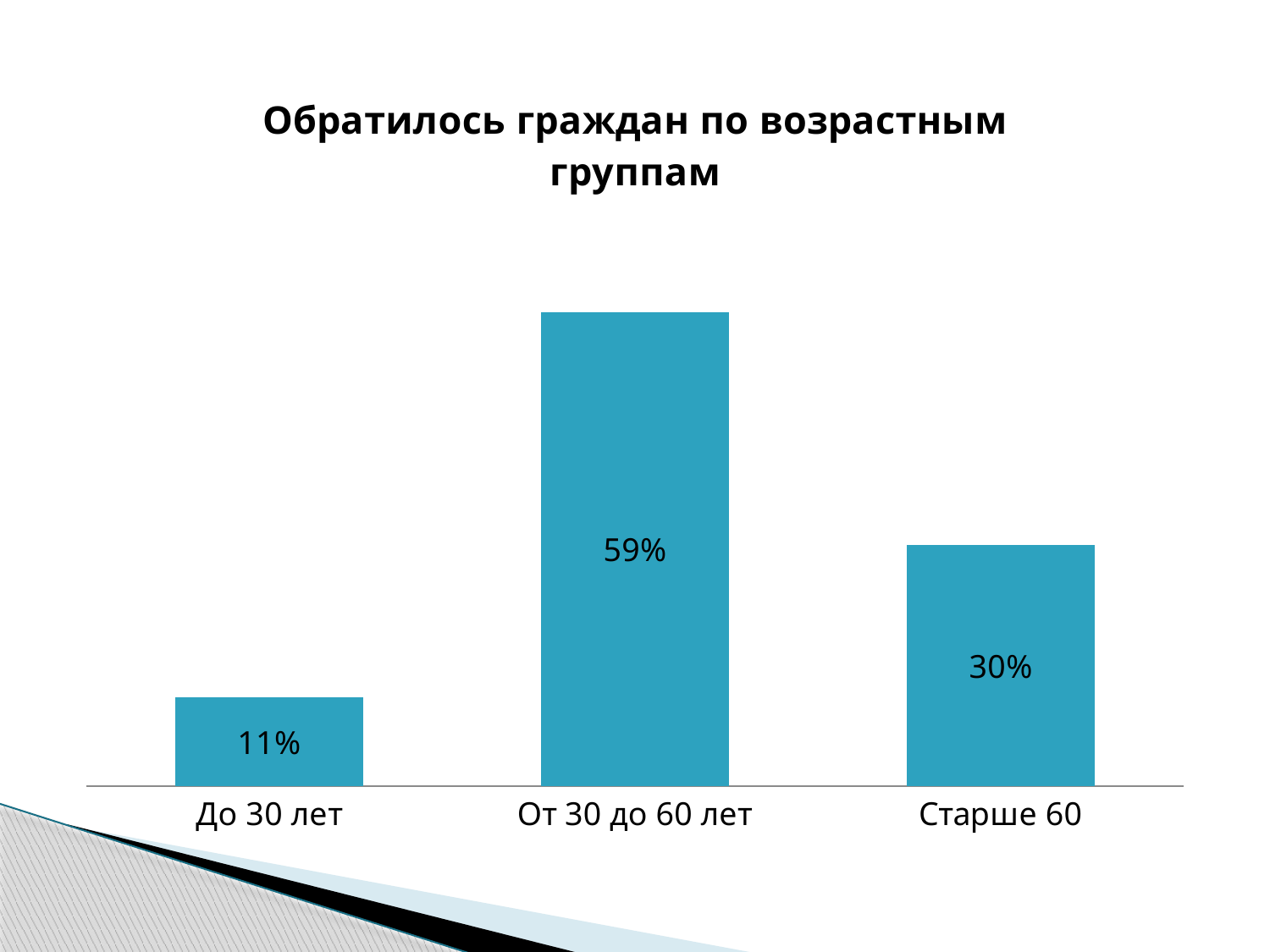
Which age group has the highest value? От 30 до 60 лет What is the value for От 30 до 60 лет? 59% What is the difference between the values for От 30 до 60 лет and Старше 60? 29% What is the value for Старше 60? 30% What is the value for До 30 лет? 11% What colour are the bars in the chart? Blue How many age groups are shown in the chart? 3 Which is larger, the value for Старше 60 or the value for До 30 лет? Старше 60 What is the difference between the values for Старше 60 and До 30 лет? 19% What kind of chart is shown on the slide? Bar chart What is the title of the chart? Обратилось граждан по возрастным группам Which age group has the lowest value? До 30 лет